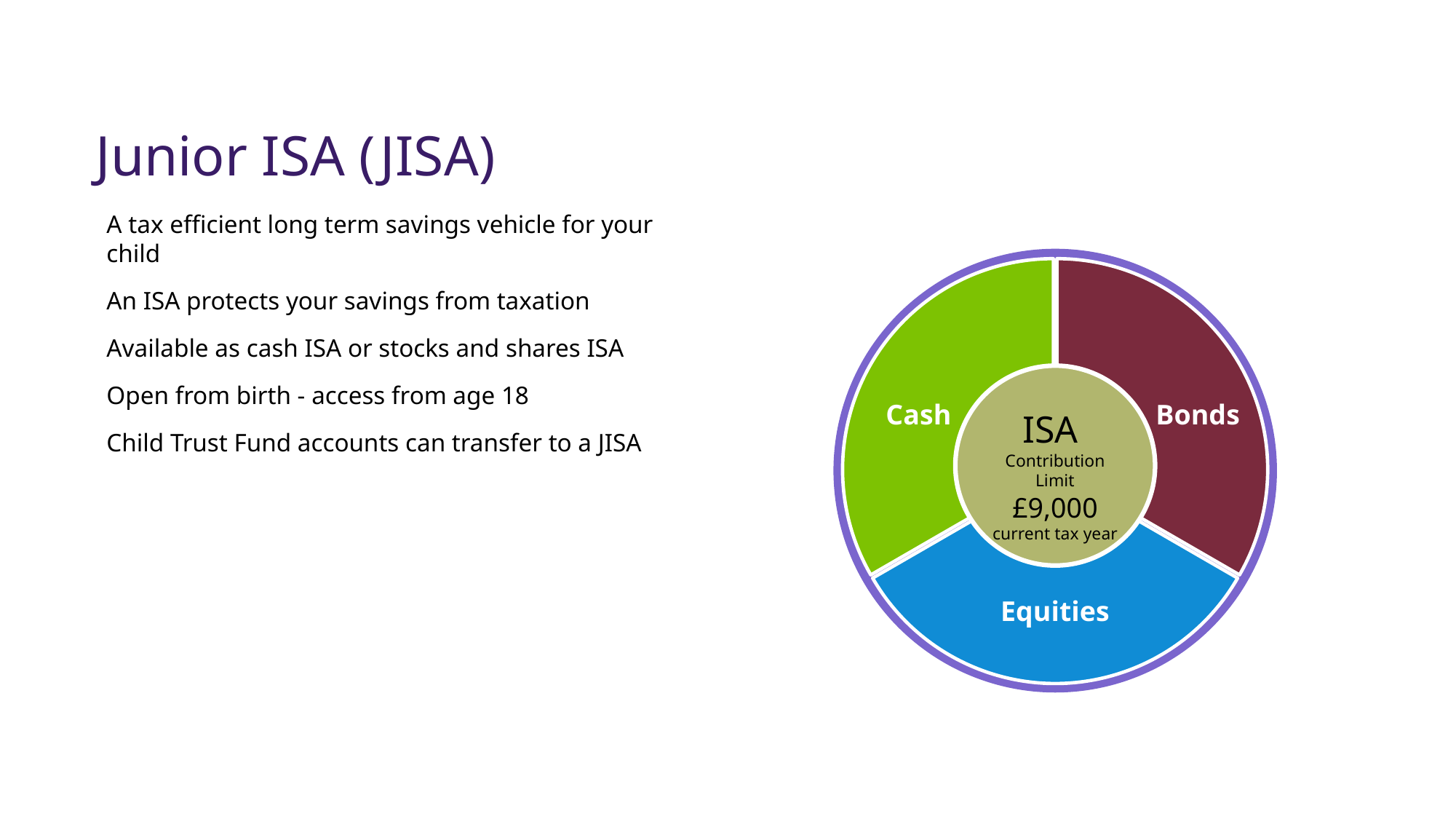
Which segment of the circular diagram is coloured blue? Equities How many segments does the circular diagram on the right of the slide have? 3 What are the three segment labels on the circular diagram? Cash, Bonds, Equities What contribution limit is shown in the centre of the circular diagram? £9,000